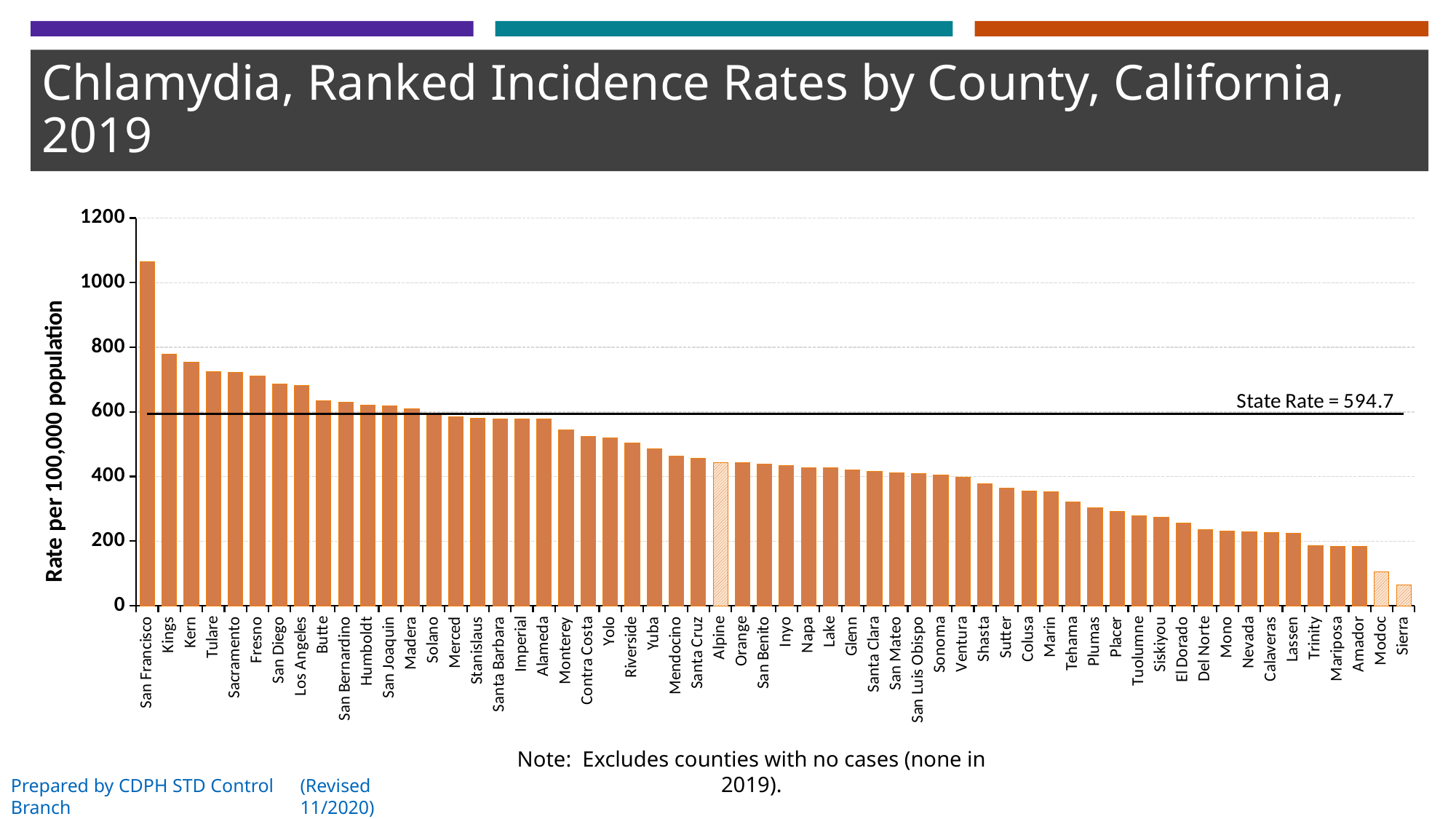
Which county has the lowest chlamydia incidence rate? Sierra How many counties are plotted on the chart? 58 Which county has the highest chlamydia incidence rate? San Francisco Is the value for Kings greater or less than 800? less Which county has a higher rate, Kern or Fresno? Kern What is the state rate shown by the horizontal line on the chart? 594.7 Is the value for Modoc greater or less than 200? less What is the label of the y axis? Rate per 100,000 population Is the value for Orange greater or less than 400? greater Do the bar values rise or fall moving from left to right along the x axis? fall What kind of chart is shown on the slide? bar chart